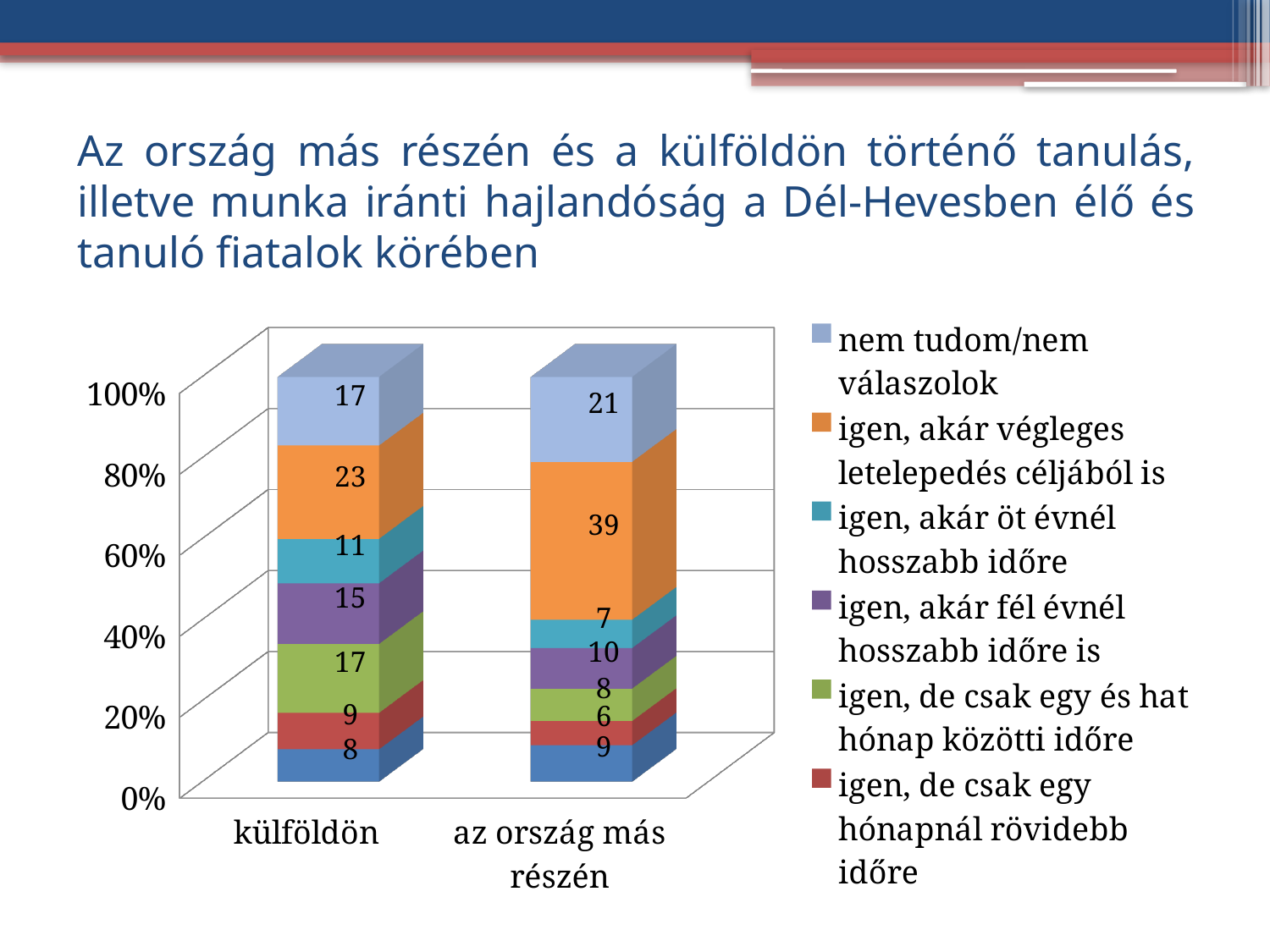
What type of chart is shown on the slide? stacked bar chart How many series does the legend list? 6 What is the value of "igen, akár végleges letelepedés céljából is" for "külföldön"? 23 How many categories are shown on the x axis of the chart? 2 Which series has the largest value in the "az ország más részén" bar? igen, akár végleges letelepedés céljából is What is the value of "nem tudom/nem válaszolok" for "az ország más részén"? 21 What is the total of the labelled segments in the "külföldön" bar? 100 Which category has the larger value for "igen, akár öt évnél hosszabb időre": "külföldön" or "az ország más részén"? külföldön What is the value of "igen, akár fél évnél hosszabb időre is" for "külföldön"? 15 What is the value of "igen, akár végleges letelepedés céljából is" for "az ország más részén"? 39 What colour is the segment for "igen, akár végleges letelepedés céljából is"? orange What is the difference between the "igen, akár végleges letelepedés céljából is" values for "az ország más részén" and "külföldön"? 16